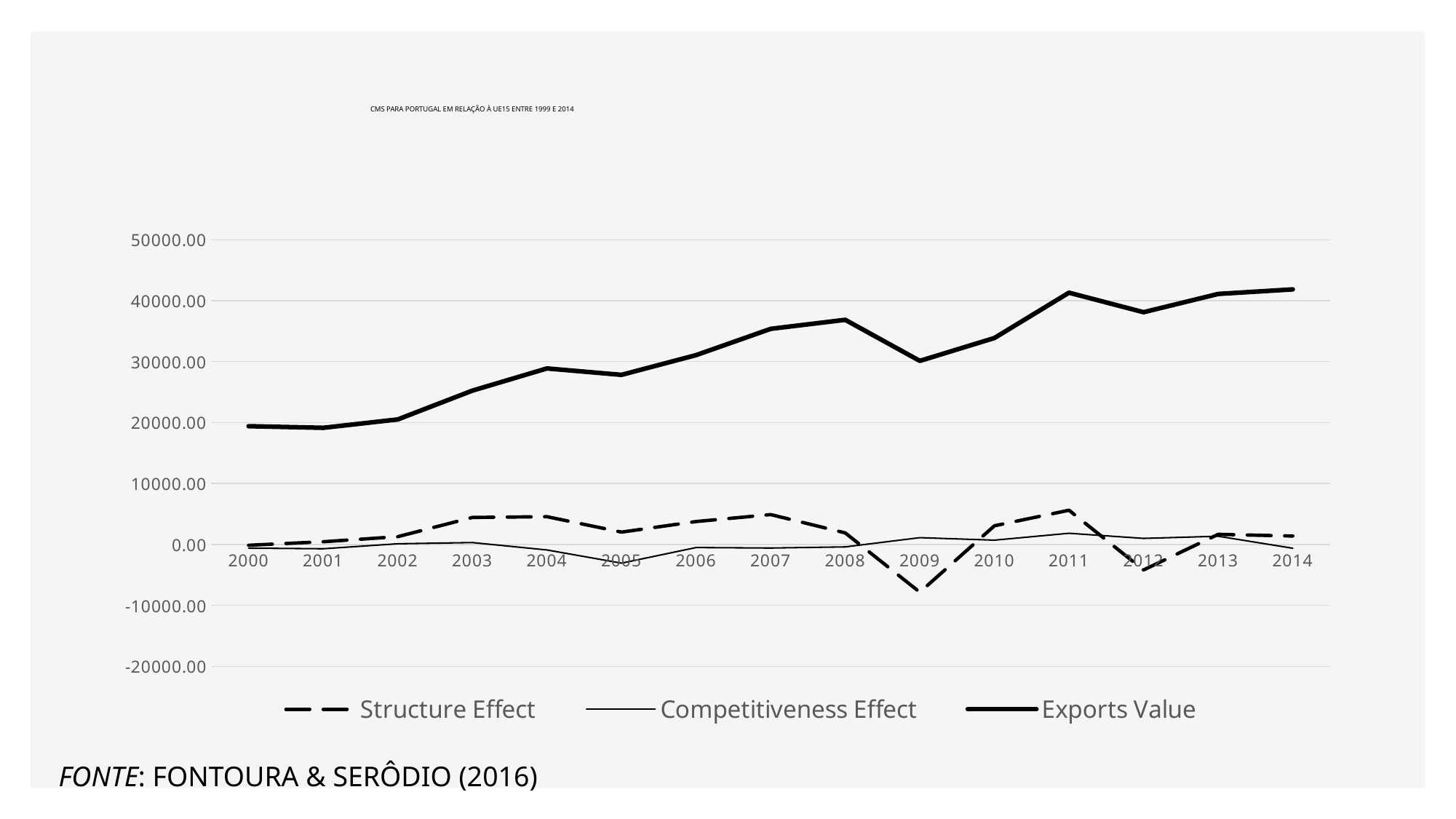
How many series does the legend list? 3 Is the Exports Value for 2000 greater or less than 20000.00? less Is the Exports Value for 2014 greater or less than 40000.00? greater In which year is the Structure Effect at its lowest? 2009 What kind of chart is shown on the slide? Line chart How many years are plotted along the x axis? 15 Which is larger, the Exports Value in 2011 or in 2012? 2011 Is the Exports Value for 2008 greater or less than 30000.00? greater Which series is drawn with a dashed line? Structure Effect Which is larger, the Exports Value in 2008 or in 2009? 2008 Does the Exports Value series generally rise or fall from 2000 to 2014? Rise